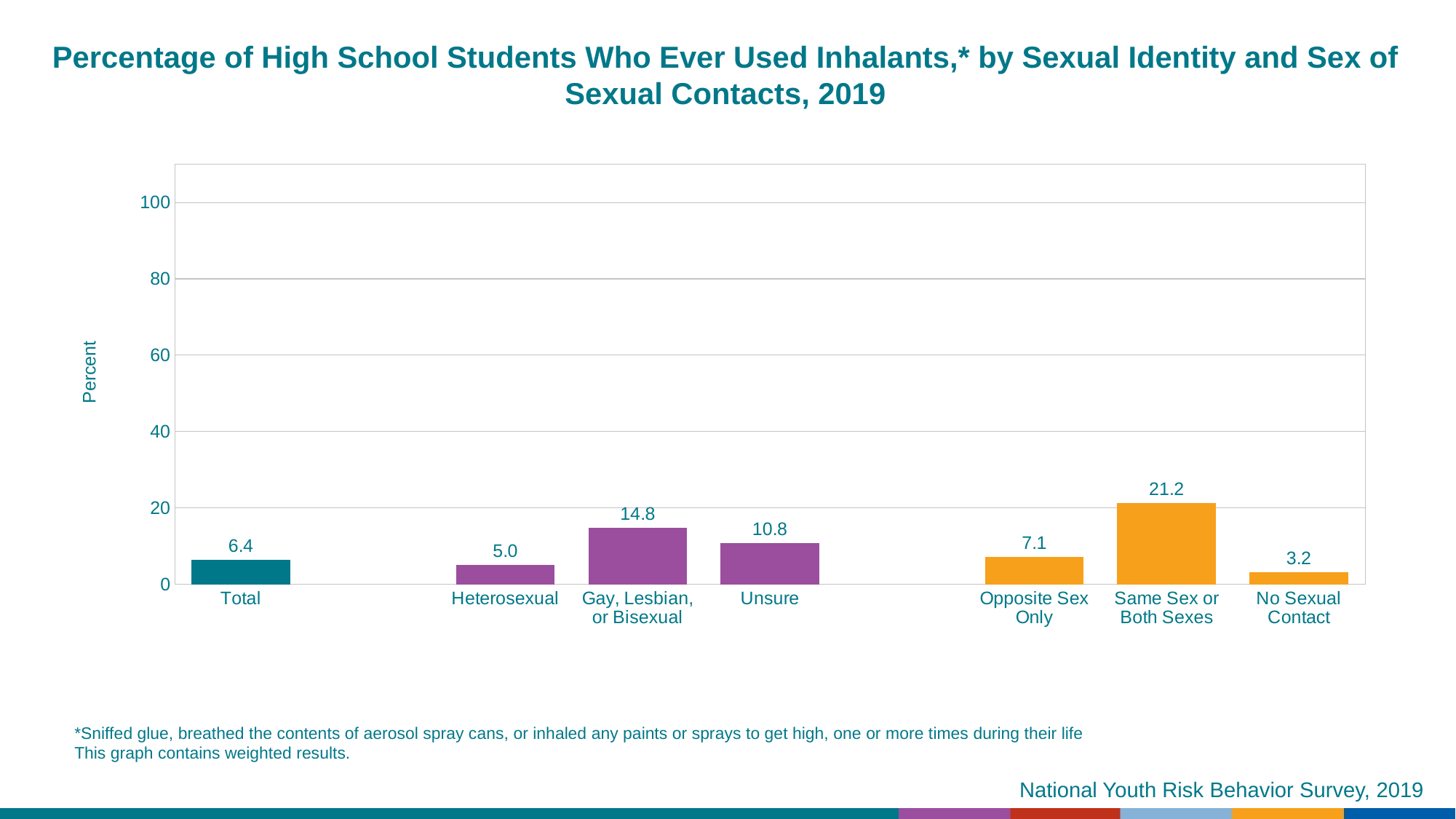
Which category has the lowest value? No Sexual Contact Which category has the highest value? Same Sex or Both Sexes What is the value for Same Sex or Both Sexes? 21.2 What is the value for Total? 6.4 How many categories are shown on the x axis? 7 What is the value for No Sexual Contact? 3.2 What is the label on the y axis? Percent Is the value for Same Sex or Both Sexes greater or less than 20? greater What kind of chart is this? bar chart Which is larger, the value for Opposite Sex Only or the value for Heterosexual? Opposite Sex Only What is the value for Gay, Lesbian, or Bisexual students? 14.8 What is the difference between the values for Unsure and Heterosexual? 5.8